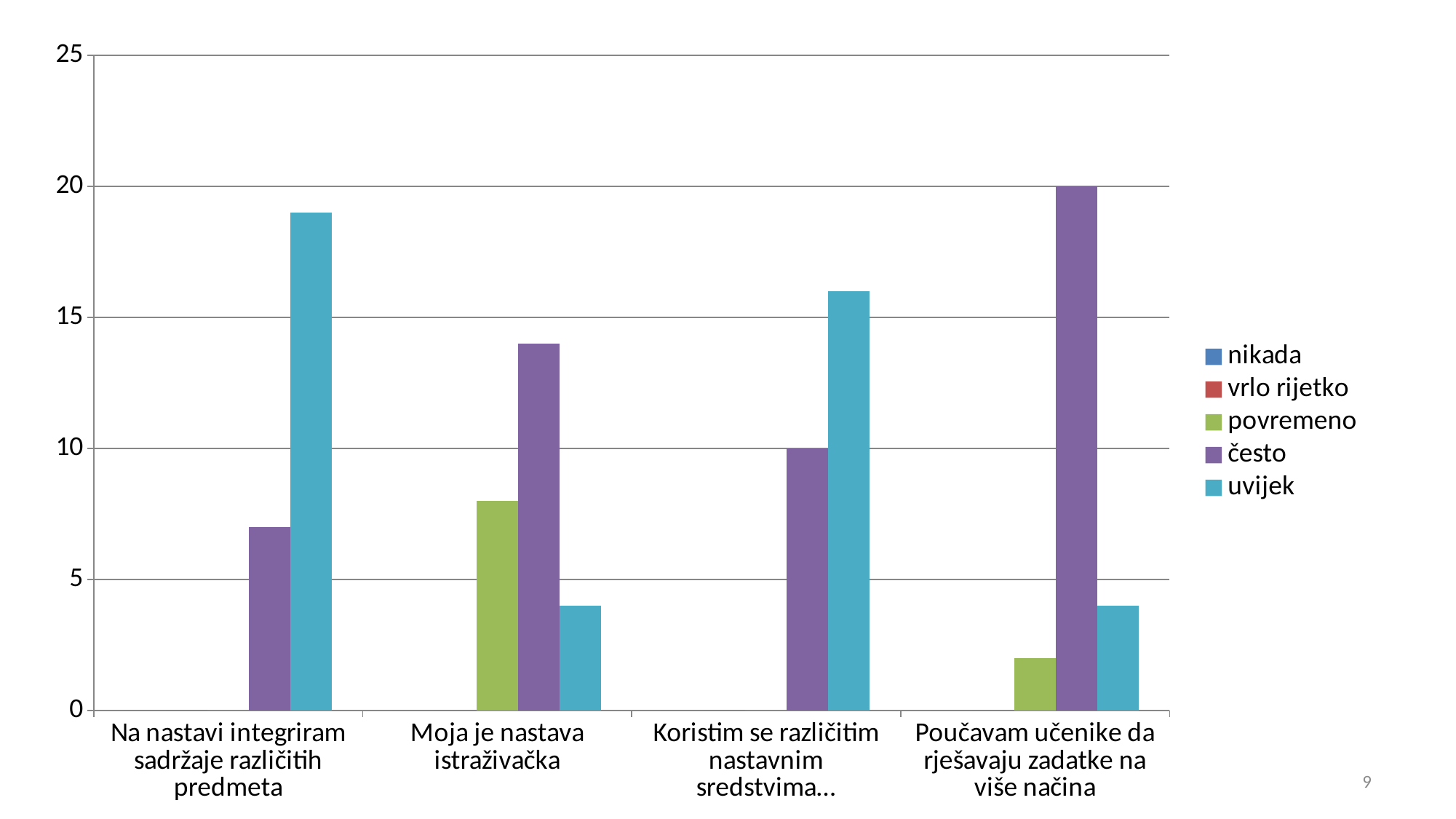
What is the value of "često" for "Poučavam učenike da rješavaju zadatke na više načina"? 20 How many series does the legend list? 5 Which category has the highest "uvijek" value? Na nastavi integriram sadržaje različitih predmeta Which category has the highest "često" value? Poučavam učenike da rješavaju zadatke na više načina Is the value of "uvijek" for "Na nastavi integriram sadržaje različitih predmeta" greater or less than 15? greater What is the difference between the "često" values for "Poučavam učenike da rješavaju zadatke na više načina" and "Koristim se različitim nastavnim sredstvima…"? 10 What is the value of "često" for "Koristim se različitim nastavnim sredstvima…"? 10 How many categories are shown on the x axis? 4 What kind of chart is shown on the slide? bar chart Is the value of "povremeno" for "Moja je nastava istraživačka" greater or less than 10? less Which legend entry is shown in purple? često For "Moja je nastava istraživačka", which is larger: "često" or "uvijek"? često